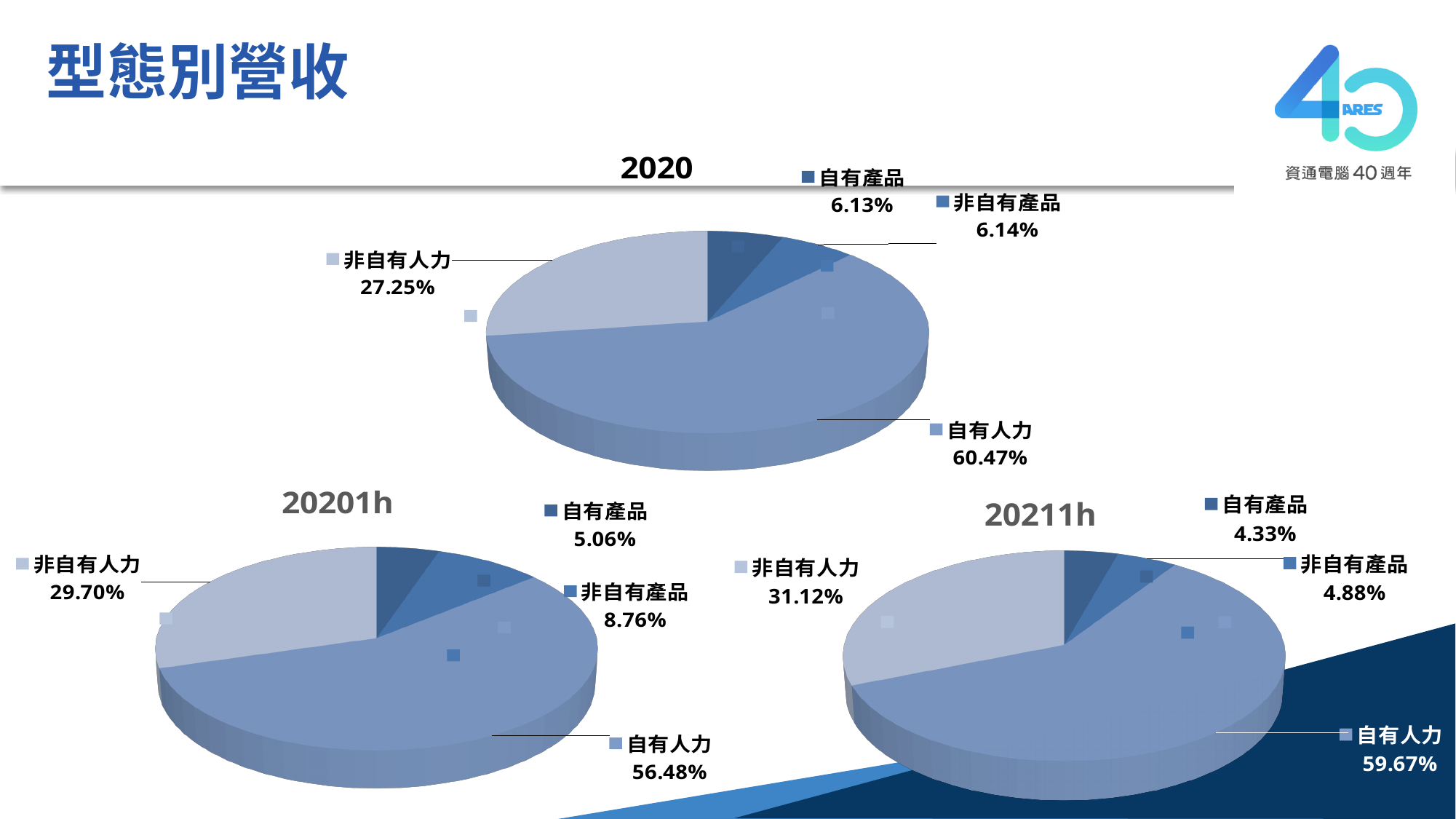
In the 20211h chart, what is the share for 自有產品? 4.33% In the 20211h chart, what is the difference between the shares of 自有人力 and 非自有人力? 28.55% In the 20201h chart, which category has the smallest share? 自有產品 In the 20201h chart, which is larger, the share of 非自有人力 or 非自有產品? 非自有人力 How many pie charts are shown on the slide? 3 What kind of chart is the 2020 chart? Pie chart In the 2020 chart, what is the difference between the shares of 自有人力 and 非自有人力? 33.22% How many slices does the 20211h pie chart have? 4 In the 2020 chart, what is the share for 自有人力? 60.47% In the 20201h chart, what is the share for 非自有產品? 8.76% In the 2020 chart, what is the share for 非自有人力? 27.25% In the 20211h chart, which category has the largest share? 自有人力